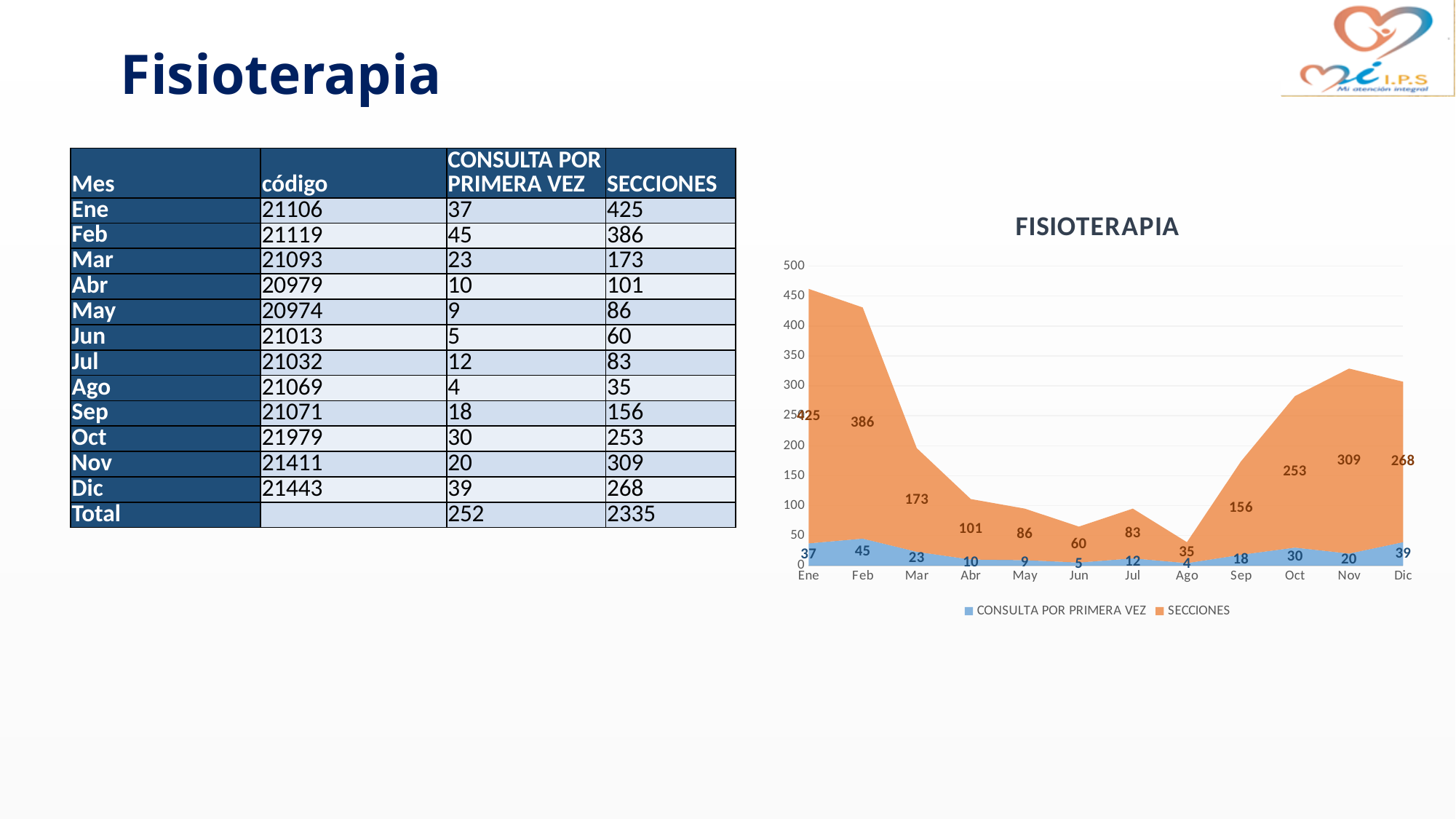
What is the SECCIONES value for Ene in the chart? 425 How many months are plotted along the x axis of the chart? 12 What is the title of the chart? FISIOTERAPIA What is the combined total of CONSULTA POR PRIMERA VEZ and SECCIONES for Ene in the chart? 462 Which month has the larger SECCIONES value, Oct or Nov? Nov Do the SECCIONES values rise or fall from Ene to Ago in the chart? Fall How many series does the chart legend list? 2 Which month has the lowest CONSULTA POR PRIMERA VEZ value in the chart? Ago What is the CONSULTA POR PRIMERA VEZ value for Dic in the chart? 39 Which month has the highest SECCIONES value in the chart? Ene What is the difference between the SECCIONES values for Ene and Feb? 39 What type of chart is shown on the slide? Area chart